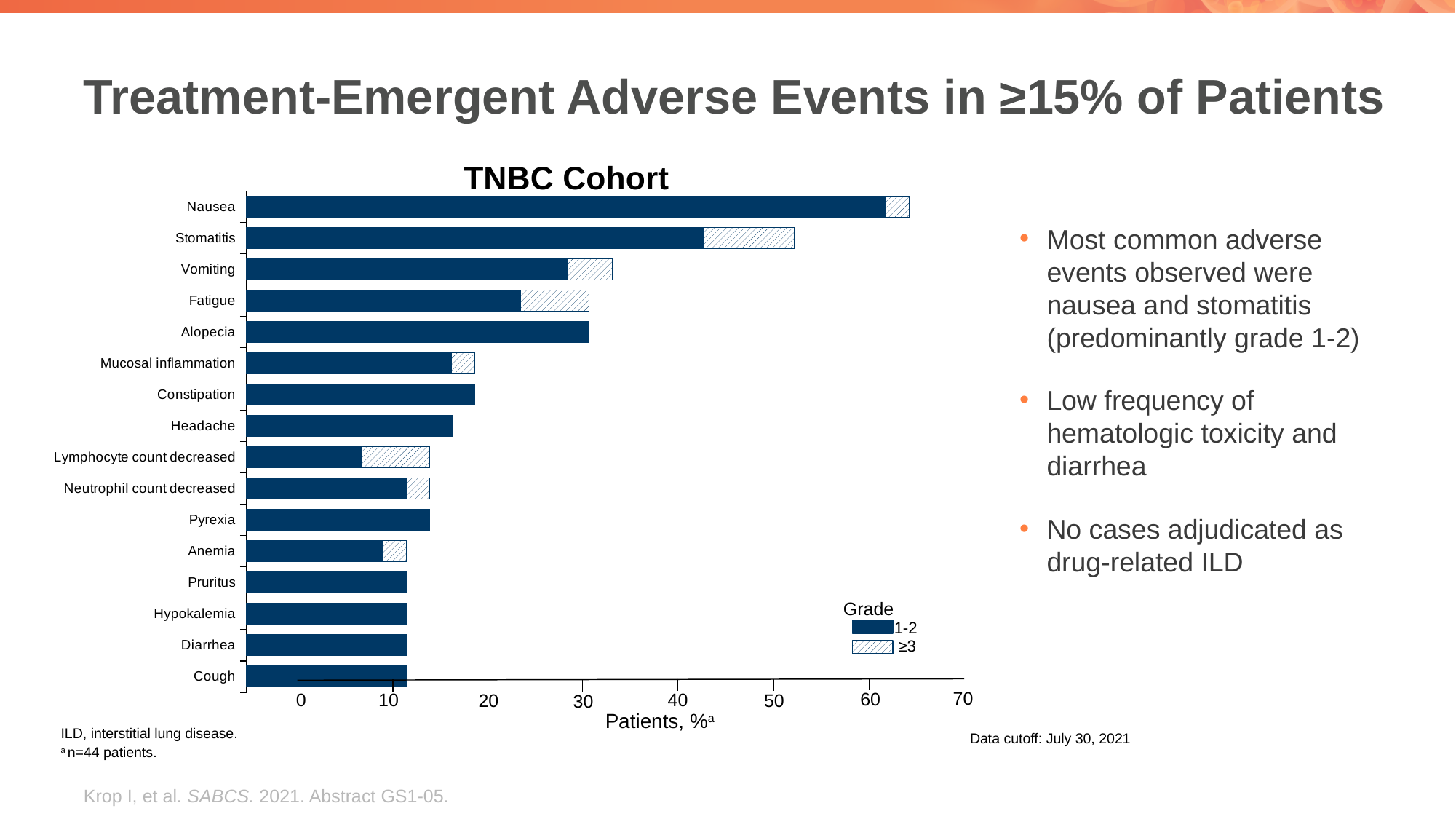
Is the value for Cough greater or less than 10? greater Is the total value for Nausea greater or less than 60? greater What kind of chart is shown on the slide? Bar chart Which adverse event has the highest total percentage of patients? Nausea Which has a larger total percentage of patients, Stomatitis or Vomiting? Stomatitis How many series does the chart's legend list? 2 What is the title of the chart? TNBC Cohort What are the two grade categories listed in the chart's legend? 1-2 and ≥3 How many adverse event categories are plotted in the chart? 16 Is the total value for Stomatitis greater or less than 50? greater